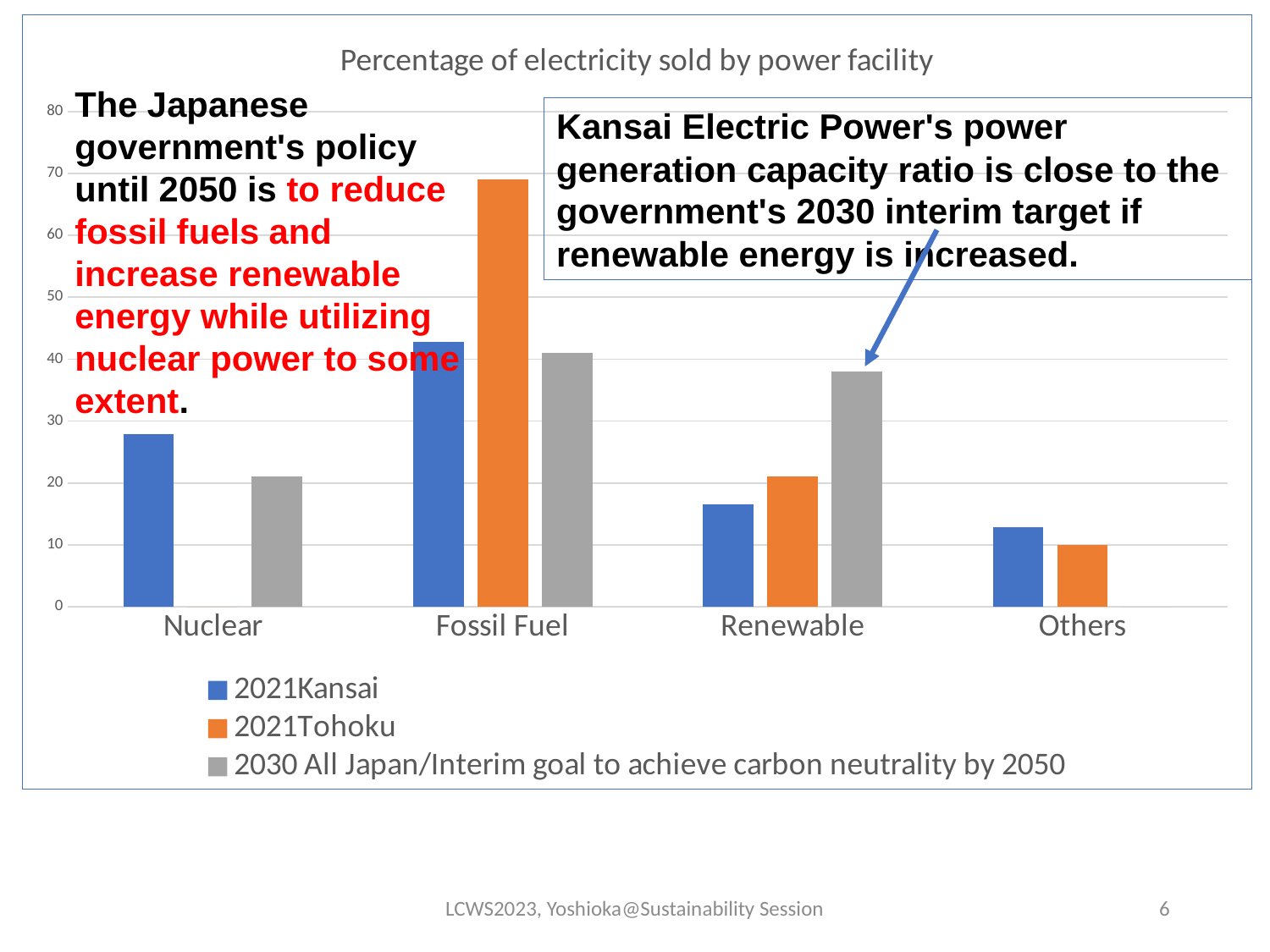
Which category has the lowest 2021Kansai value? Others Which category has the highest 2021Tohoku value? Fossil Fuel What is the title of the chart? Percentage of electricity sold by power facility For Fossil Fuel, which is larger: the 2021Kansai value or the 2021Tohoku value? 2021Tohoku How many series does the chart's legend list? 3 Is the 2021Tohoku value for Fossil Fuel greater or less than 60? greater Is the 2021Kansai value for Nuclear greater or less than 30? less How many categories are shown on the x axis of the chart? 4 Is the 2030 All Japan value for Renewable greater or less than 30? greater What kind of chart is shown on the slide? bar chart Which category has the highest 2021Kansai value? Fossil Fuel For Renewable, which is larger: the 2021Kansai value or the 2030 All Japan/Interim goal value? 2030 All Japan/Interim goal to achieve carbon neutrality by 2050